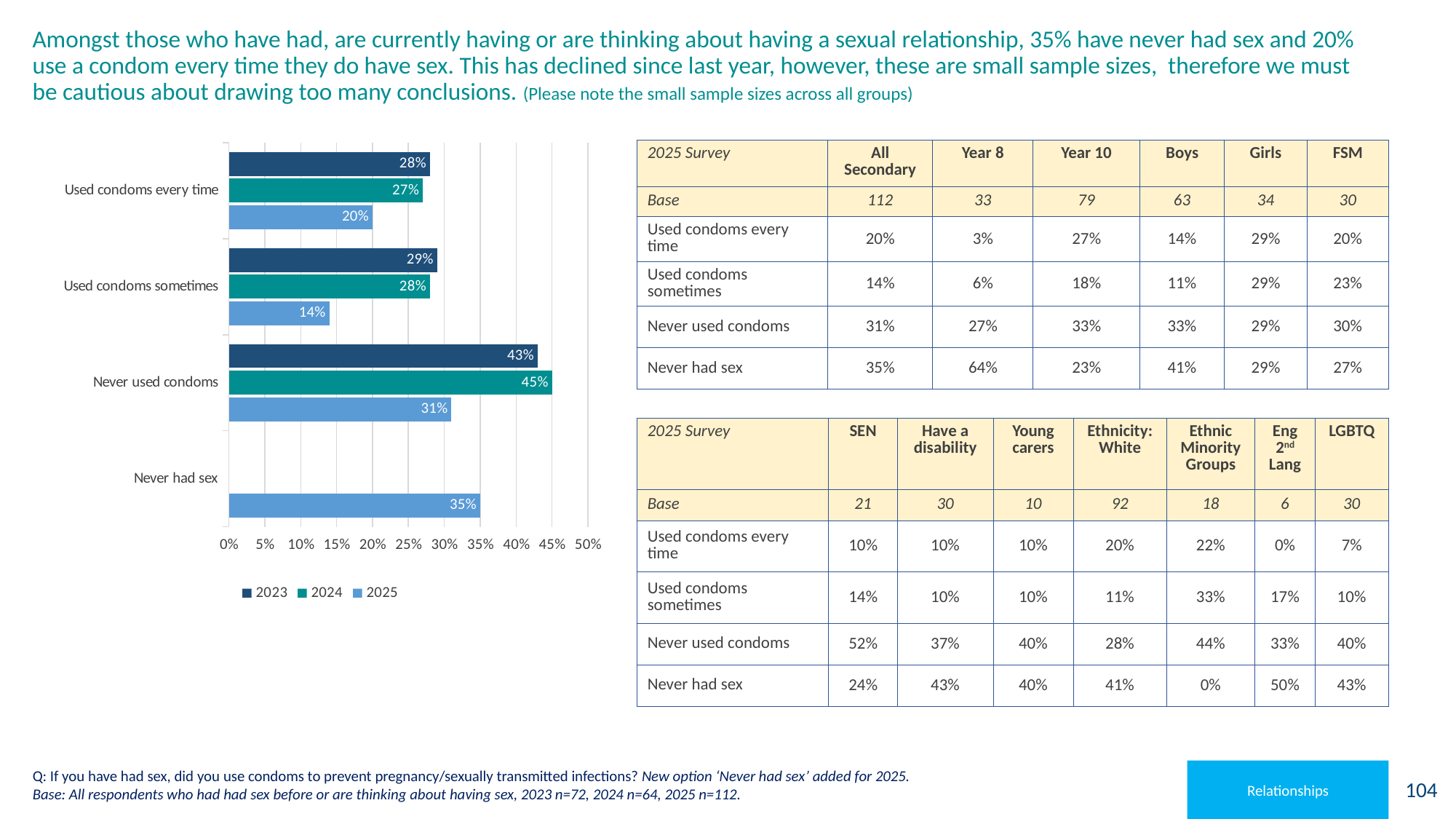
In the bar chart, how does the 'Used condoms every time' value change from 2023 to 2025? It falls What is the 2025 value for 'Never used condoms' in the bar chart? 31% Which category has the lowest 2025 value in the bar chart? Used condoms sometimes In the bar chart, which is larger for 'Used condoms sometimes': the 2023 value or the 2025 value? 2023 How many series does the legend of the bar chart list? 3 What is the 2023 value for 'Used condoms sometimes' in the bar chart? 29% Which series in the bar chart has a value for 'Never had sex'? 2025 What kind of chart is shown on the slide? Bar chart How many categories are shown on the bar chart's vertical axis? 4 In the bar chart, what is the difference between the 2024 and 2025 values for 'Never used condoms'? 14% Which category has the highest 2024 value in the bar chart? Never used condoms What is the 2024 value for 'Used condoms every time' in the bar chart? 27%